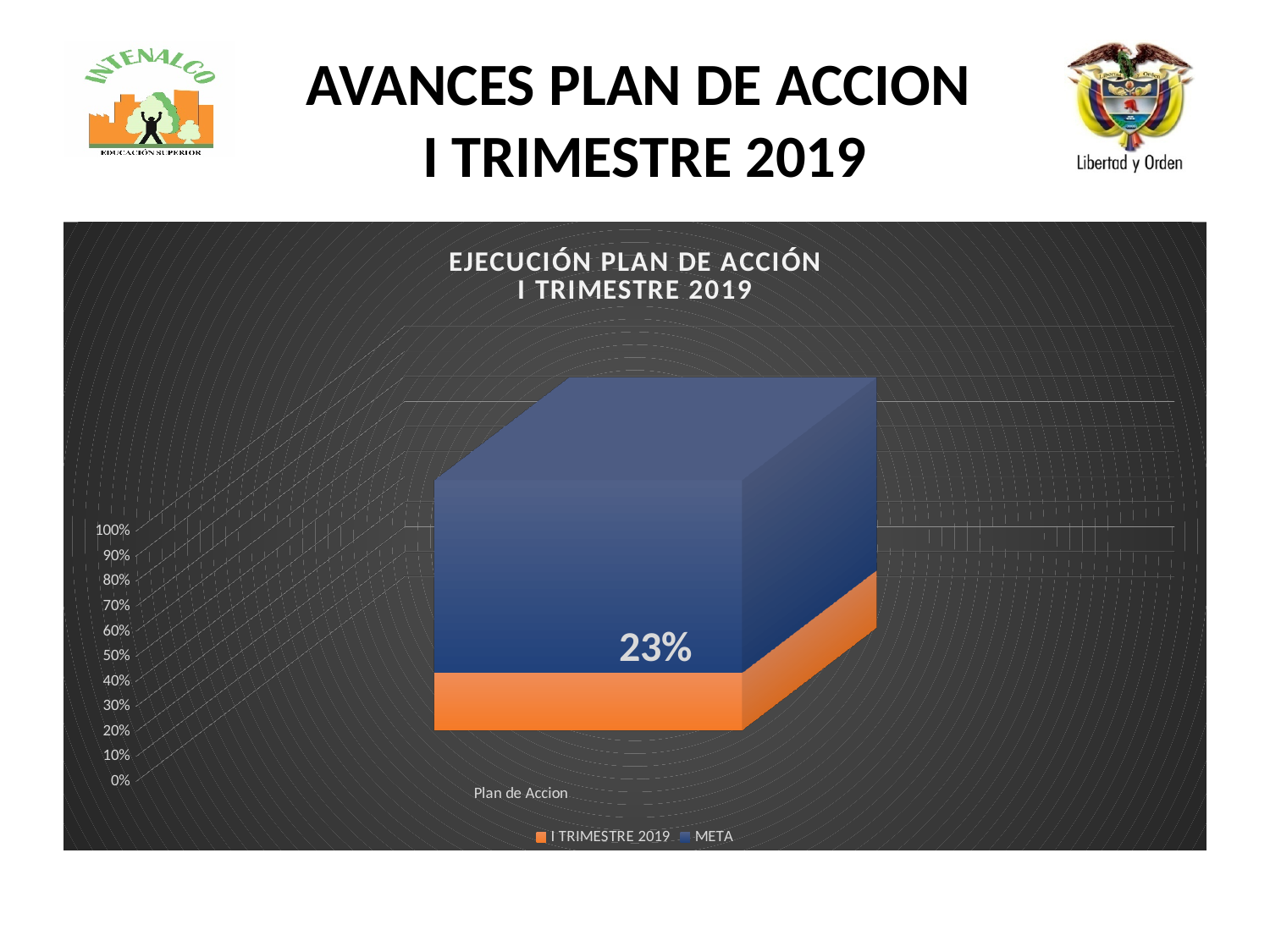
What is the highest value shown on the vertical axis? 100% Which series occupies the largest portion of the stacked bar? META What is the name of the category shown on the x axis? Plan de Accion What kind of chart is shown on the slide? bar chart What is the value of I TRIMESTRE 2019 for Plan de Accion? 23% Which colour represents the META series in the legend? blue Is the value for I TRIMESTRE 2019 greater or less than 50%? less Which series has the larger segment in the Plan de Accion bar, META or I TRIMESTRE 2019? META What is the title of the chart? EJECUCIÓN PLAN DE ACCIÓN I TRIMESTRE 2019 How many series does the legend list? 2 How many categories are plotted on the x axis? 1 Is the META segment of the bar greater or less than 50%? greater